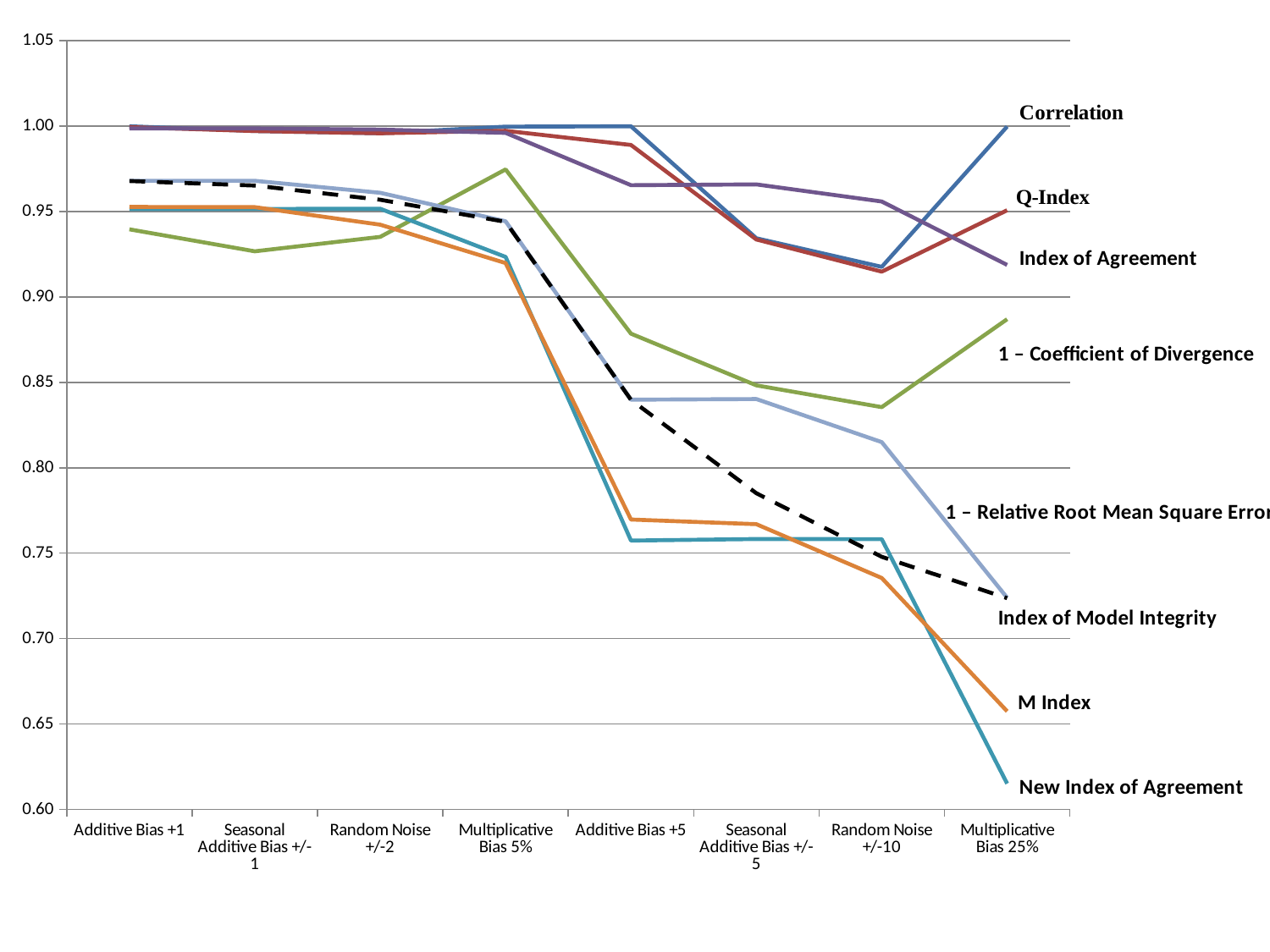
Does the New Index of Agreement series generally rise or fall from left to right across the x axis? Fall Which series has the highest value at Multiplicative Bias 25%? Correlation At Multiplicative Bias 25%, which is higher: Correlation or Index of Agreement? Correlation Which series has the lowest value at Multiplicative Bias 25%? New Index of Agreement How many categories are shown along the x axis? 8 Which series has the lowest value at Additive Bias +1? 1 – Coefficient of Divergence Is the value of New Index of Agreement at Multiplicative Bias 25% greater or less than 0.65? less How many data series are labelled on the chart? 8 Is the value of 1 – Coefficient of Divergence at Random Noise +/-10 greater or less than 0.80? greater Which series is drawn as a dashed line? Index of Model Integrity What kind of chart is shown on the slide? Line chart Is the value of Correlation at Multiplicative Bias 25% greater or less than 0.95? greater